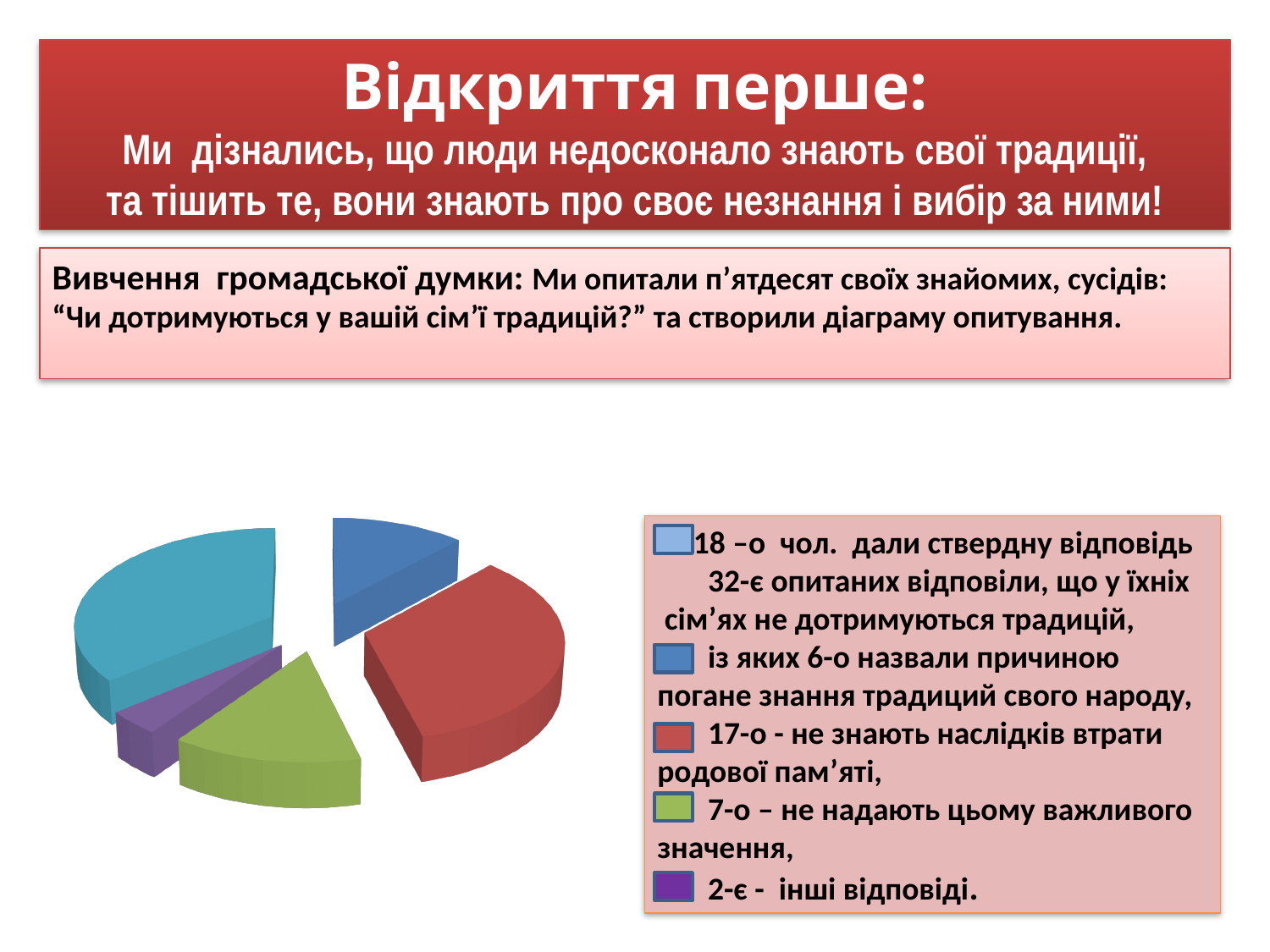
Which is larger: the group that does not know the consequences of losing family memory or the group that does not attach importance to it? не знають наслідків втрати родової пам’яті (17) What colour is the slice representing the 17 respondents who do not know the consequences of losing family memory? red How many respondents named poor knowledge of their people's traditions as the reason (погане знання традиций свого народу)? 6 How many respondents gave other answers (інші відповіді)? 2 Which response group is the largest slice of the pie? дали ствердну відповідь (18) How many people gave an affirmative answer (дали ствердну відповідь) according to the chart legend? 18 Which response group is the smallest slice of the pie? інші відповіді (2) What is the difference between the number who do not know the consequences (17) and the number who do not attach importance (7)? 10 What kind of chart is shown on the slide? pie chart How many respondents do not attach importance to this (не надають цьому важливого значення)? 7 How many respondents do not know the consequences of losing family memory (не знають наслідків втрати родової пам’яті)? 17 How many slices does the pie chart have? 5